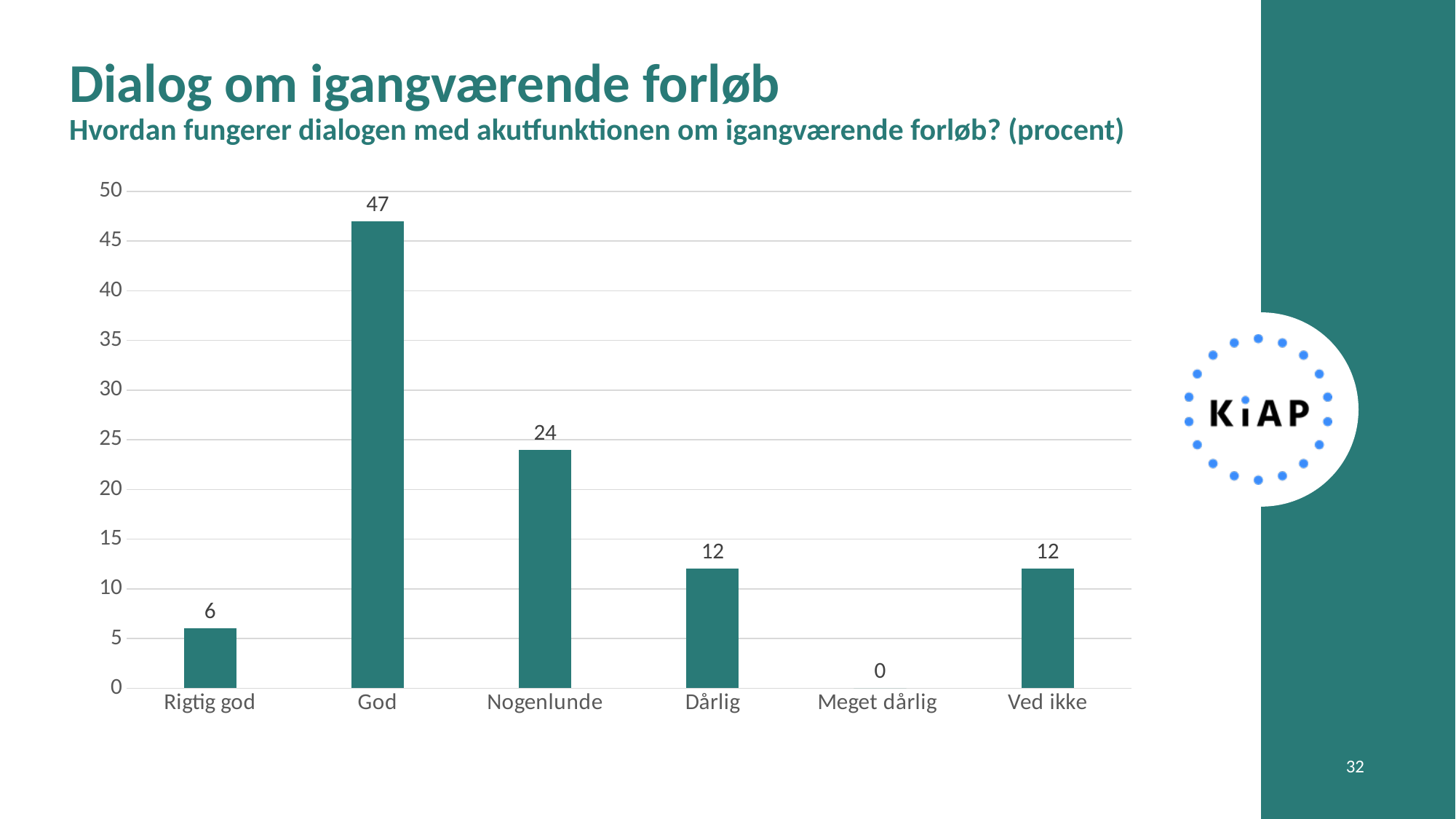
Is the value for Nogenlunde greater or less than 20? greater Which category has the highest value? God What is the value for Rigtig god? 6 What is the value for Nogenlunde? 24 Which category has the lowest value? Meget dårlig What kind of chart is shown on the slide? bar chart What is the title of the slide? Dialog om igangværende forløb What is the value for God? 47 How many categories are shown on the x axis? 6 What is the difference between the values for God and Nogenlunde? 23 What is the value for Meget dårlig? 0 Which is larger, the value for Rigtig god or the value for Dårlig? Dårlig